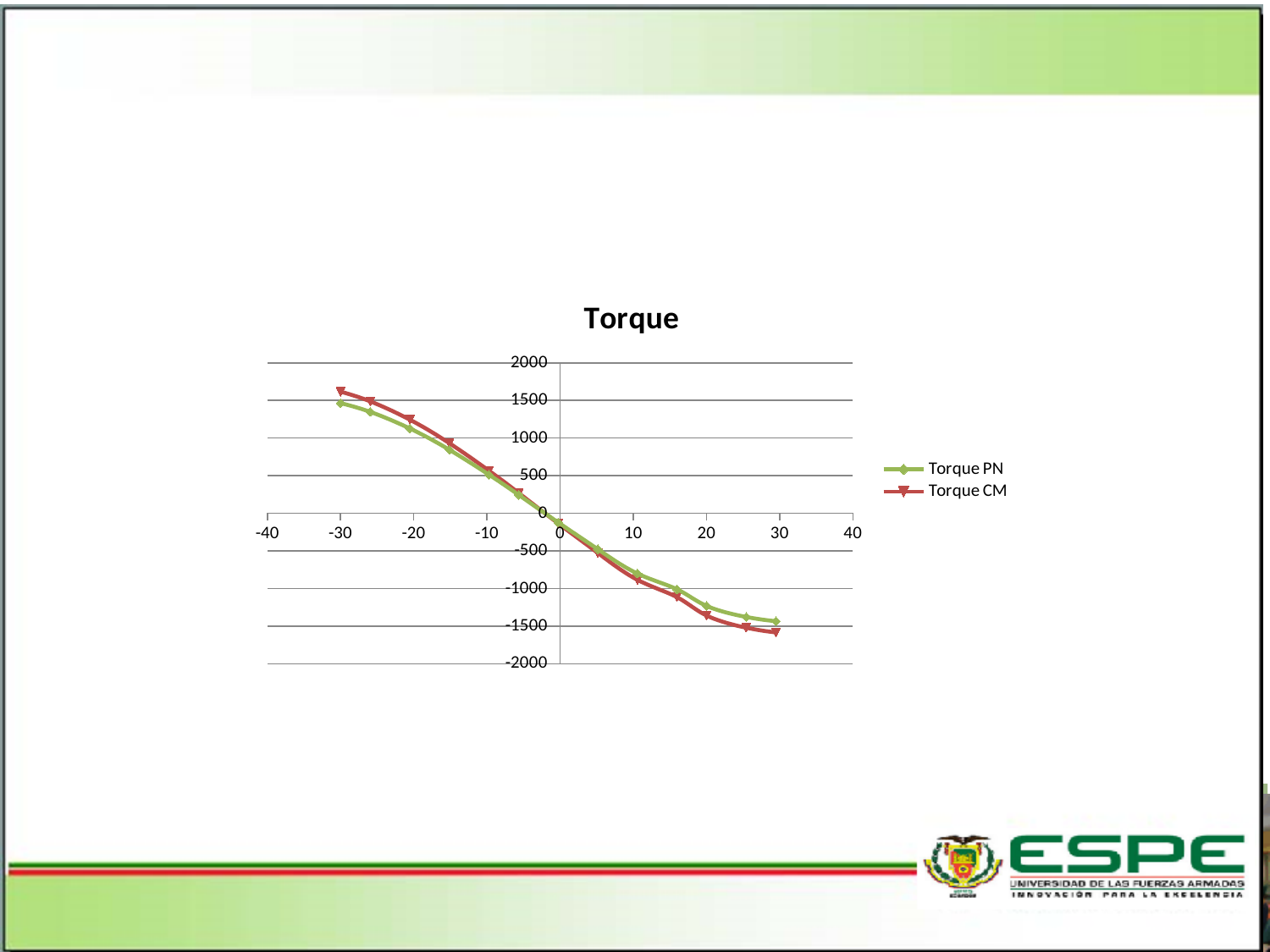
Is the value for Torque PN at x = -20 greater or less than 1000? greater Do the values of Torque CM rise or fall as the x axis increases from -30 to 30? fall What are the two series named in the legend? Torque PN and Torque CM What is the title of the chart? Torque At x = -30, which series has the larger value, Torque PN or Torque CM? Torque CM At x = 30, which series has the lower value, Torque PN or Torque CM? Torque CM Do the values of Torque PN rise or fall as the x axis increases from -30 to 30? fall Is the value for Torque CM at x = -30 greater or less than 1500? greater Is the value for Torque CM at x = 30 greater or less than -1500? less How many series does the legend list? 2 What kind of chart is shown on the slide? line chart